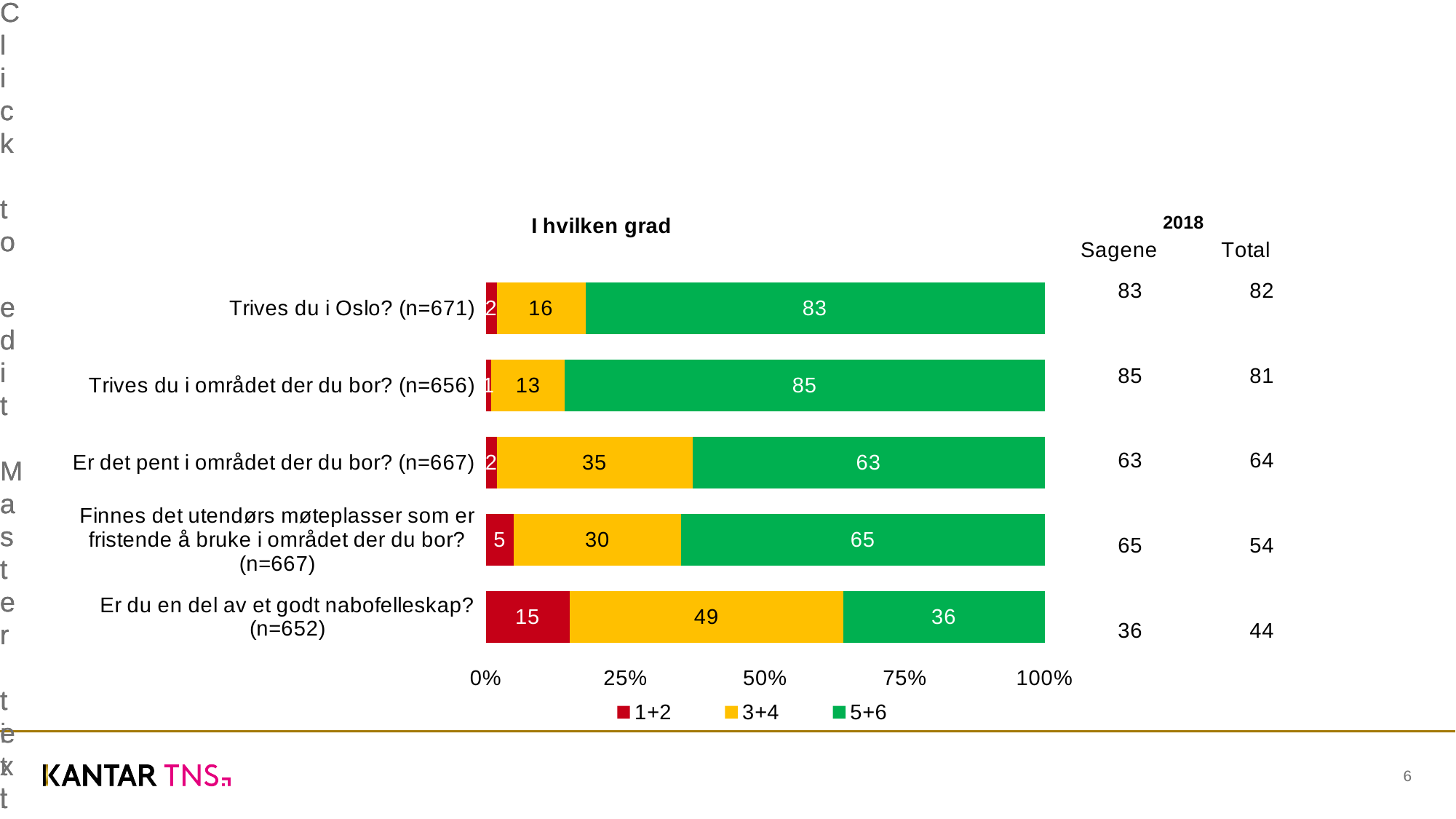
What is the 1+2 value for "Er du en del av et godt nabofelleskap? (n=652)"? 15 What is the 3+4 value for "Er det pent i området der du bor? (n=667)"? 35 Which category has the lowest 5+6 value? Er du en del av et godt nabofelleskap? (n=652) What is the total of the stacked bar for "Finnes det utendørs møteplasser som er fristende å bruke i området der du bor? (n=667)"? 100 What is the title of the chart? I hvilken grad How many categories (questions) are plotted in the chart? 5 Which category has the highest 5+6 value? Trives du i området der du bor? (n=656) What is the difference between the 5+6 values for "Trives du i Oslo? (n=671)" and "Er det pent i området der du bor? (n=667)"? 20 What kind of chart is shown on the slide? Stacked bar chart How many series does the legend list? 3 Which is larger: the 3+4 value for "Er du en del av et godt nabofelleskap? (n=652)" or the 3+4 value for "Finnes det utendørs møteplasser som er fristende å bruke i området der du bor? (n=667)"? Er du en del av et godt nabofelleskap? (n=652) What is the 5+6 value for "Trives du i området der du bor? (n=656)"? 85